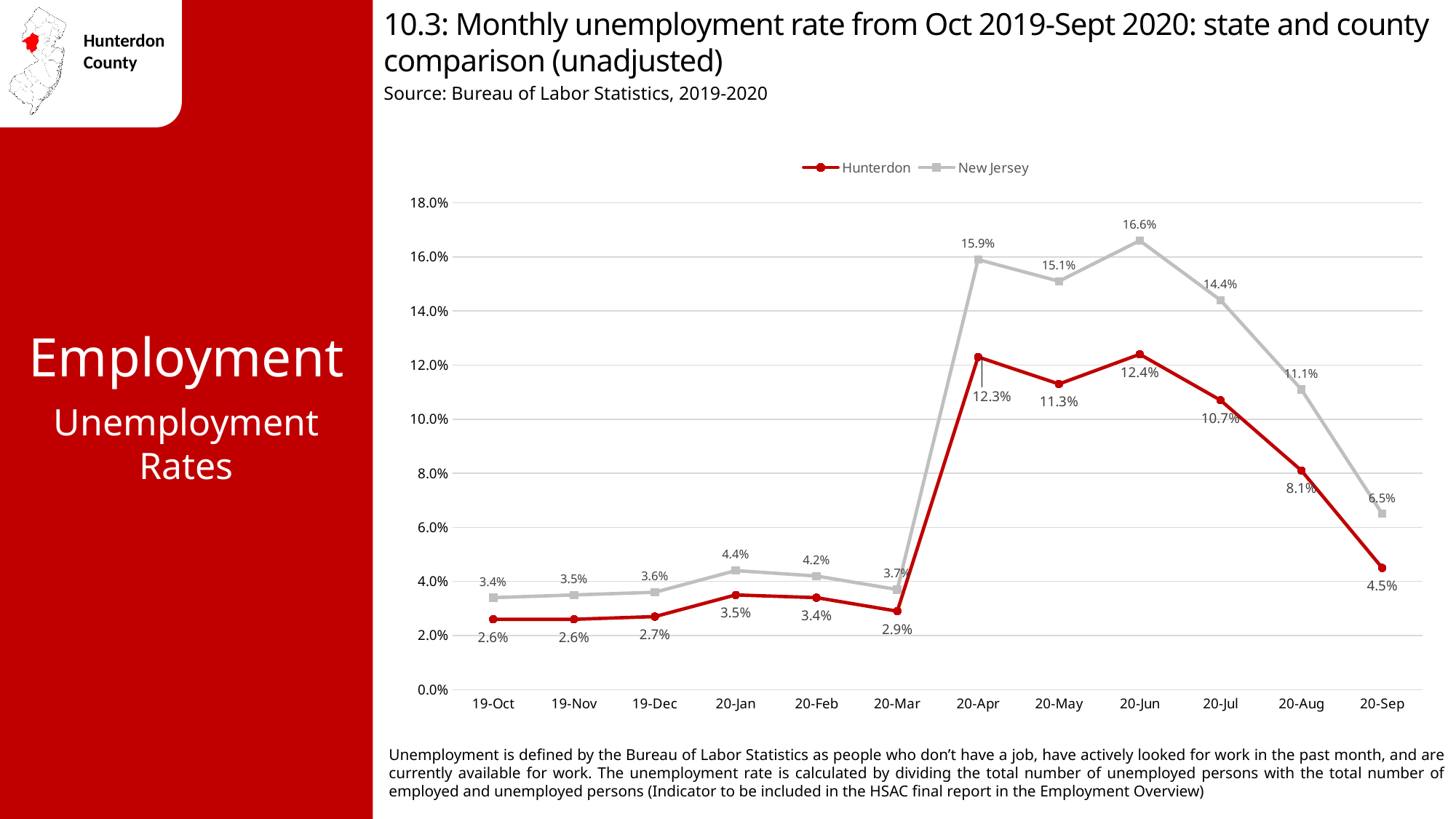
What kind of chart is shown on the slide? Line chart In which month did the New Jersey unemployment rate reach its highest value? 20-Jun What was the Hunterdon unemployment rate in 20-Sep? 4.5% What colour is the line for Hunterdon? Red How many series does the legend list? 2 How many months are plotted on the x axis? 12 In which month was the Hunterdon unemployment rate at its highest? 20-Jun What was the Hunterdon unemployment rate in 20-Apr? 12.3% What is the difference between the New Jersey and Hunterdon unemployment rates in 20-Apr? 3.6% Which series had the higher unemployment rate in 20-Aug, Hunterdon or New Jersey? New Jersey Did the Hunterdon unemployment rate rise or fall from 20-Jun to 20-Sep? Fall What was the New Jersey unemployment rate in 20-Jun? 16.6%